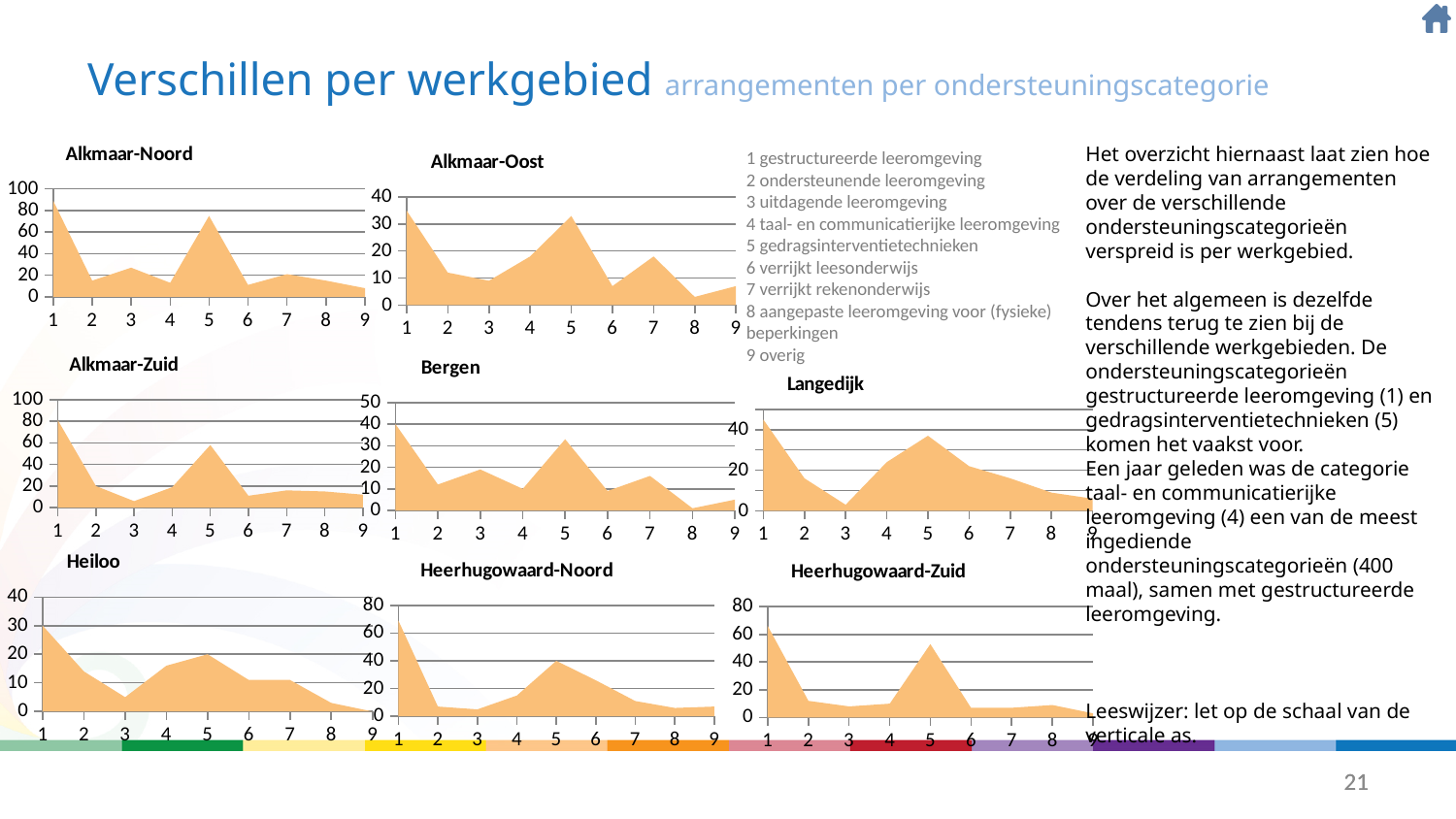
According to the legend on the slide, what does category 9 stand for? overig In the Heerhugowaard-Noord chart, is the value for category 1 greater or less than 60? greater In the Alkmaar-Zuid chart, which is larger, the value for category 1 or the value for category 5? category 1 How many categories are plotted along the x axis of the Alkmaar-Noord chart? 9 In the Alkmaar-Noord chart, which category has the highest value? 1 In the Alkmaar-Noord chart, is the value for category 1 greater or less than 80? greater In the Langedijk chart, is the value for category 1 greater or less than 40? greater How many charts are shown on the slide? 8 In the Heiloo chart, which category has the highest value? 1 What kind of chart is the Alkmaar-Noord chart? area chart In the Alkmaar-Oost chart, which category has the lowest value? 8